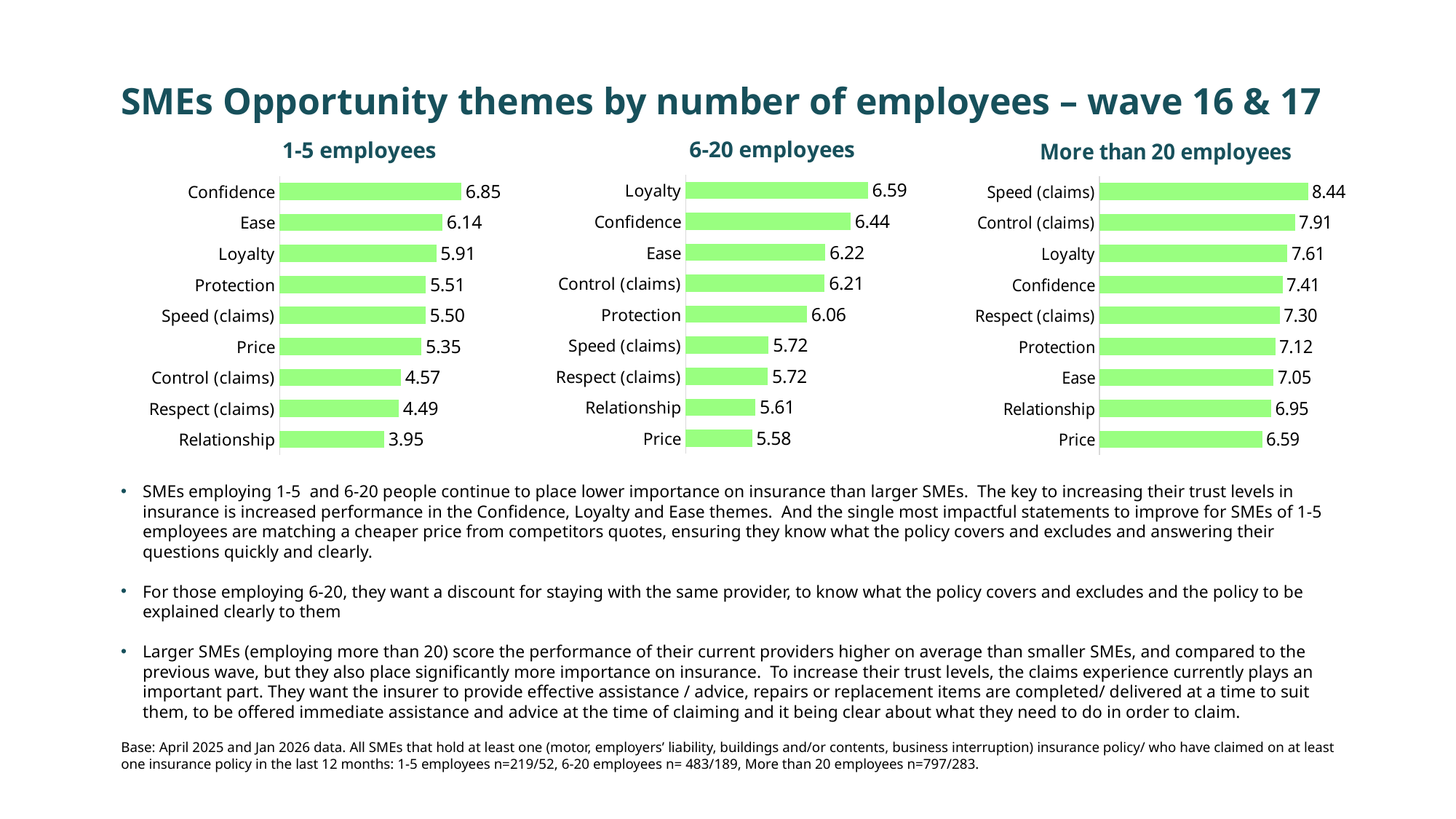
What type of chart is the '6-20 employees' chart? Bar chart How many themes are shown in the '1-5 employees' chart? 9 In the 'More than 20 employees' chart, what is the value for Relationship? 6.95 In the '1-5 employees' chart, what is the value for Confidence? 6.85 In the '1-5 employees' chart, what is the difference between Confidence and Relationship? 2.90 In the 'More than 20 employees' chart, which theme has the highest value? Speed (claims) In the '6-20 employees' chart, which theme has the lowest value? Price In the 'More than 20 employees' chart, what is the difference between Speed (claims) and Price? 1.85 In the '6-20 employees' chart, what is the value for Control (claims)? 6.21 How many charts are shown on the slide? 3 In the '1-5 employees' chart, which theme has the lowest value? Relationship In the '6-20 employees' chart, which is larger: Loyalty or Price? Loyalty